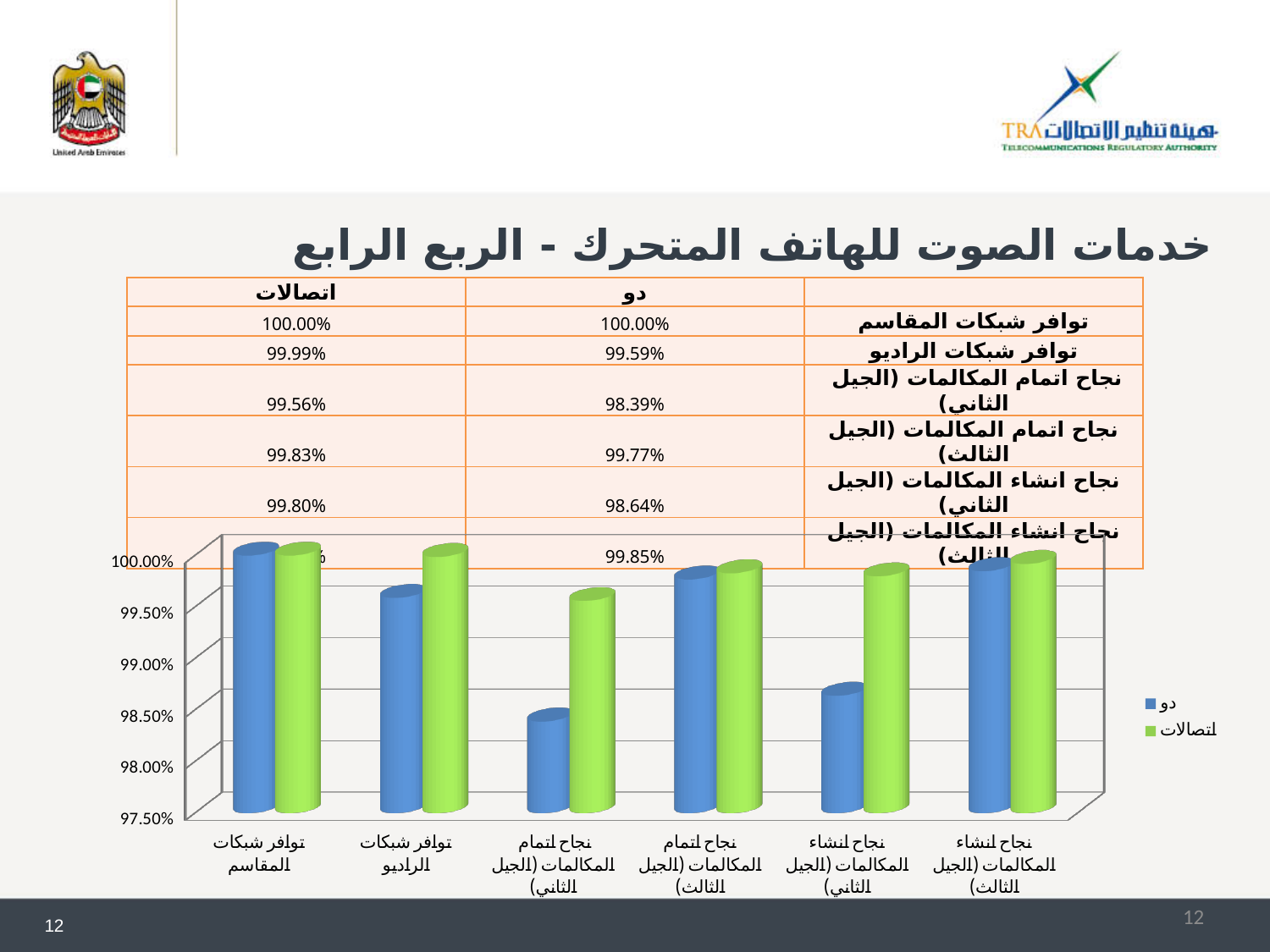
Is the value for دو in نجاح اتمام المكالمات (الجيل الثاني) greater or less than 98.50%? less According to the table on the slide, what is the difference between the اتصالات and دو values for نجاح اتمام المكالمات (الجيل الثاني)? 1.17% Which series is shown in blue in the chart? دو For which category is the دو value lowest? نجاح اتمام المكالمات (الجيل الثاني) For نجاح اتمام المكالمات (الجيل الثاني), which series has the larger value, دو or اتصالات? اتصالات What kind of chart is shown on the slide? bar chart Is the value for دو in نجاح انشاء المكالمات (الجيل الثاني) greater or less than 98.50%? greater What is the title of the slide above the chart? خدمات الصوت للهاتف المتحرك - الربع الرابع According to the table on the slide, what is the دو value for نجاح اتمام المكالمات (الجيل الثاني)? 98.39% How many categories are shown on the x axis of the chart? 6 How many series does the chart legend list? 2 Is the value for اتصالات in توافر شبكات الراديو greater or less than 99.50%? greater